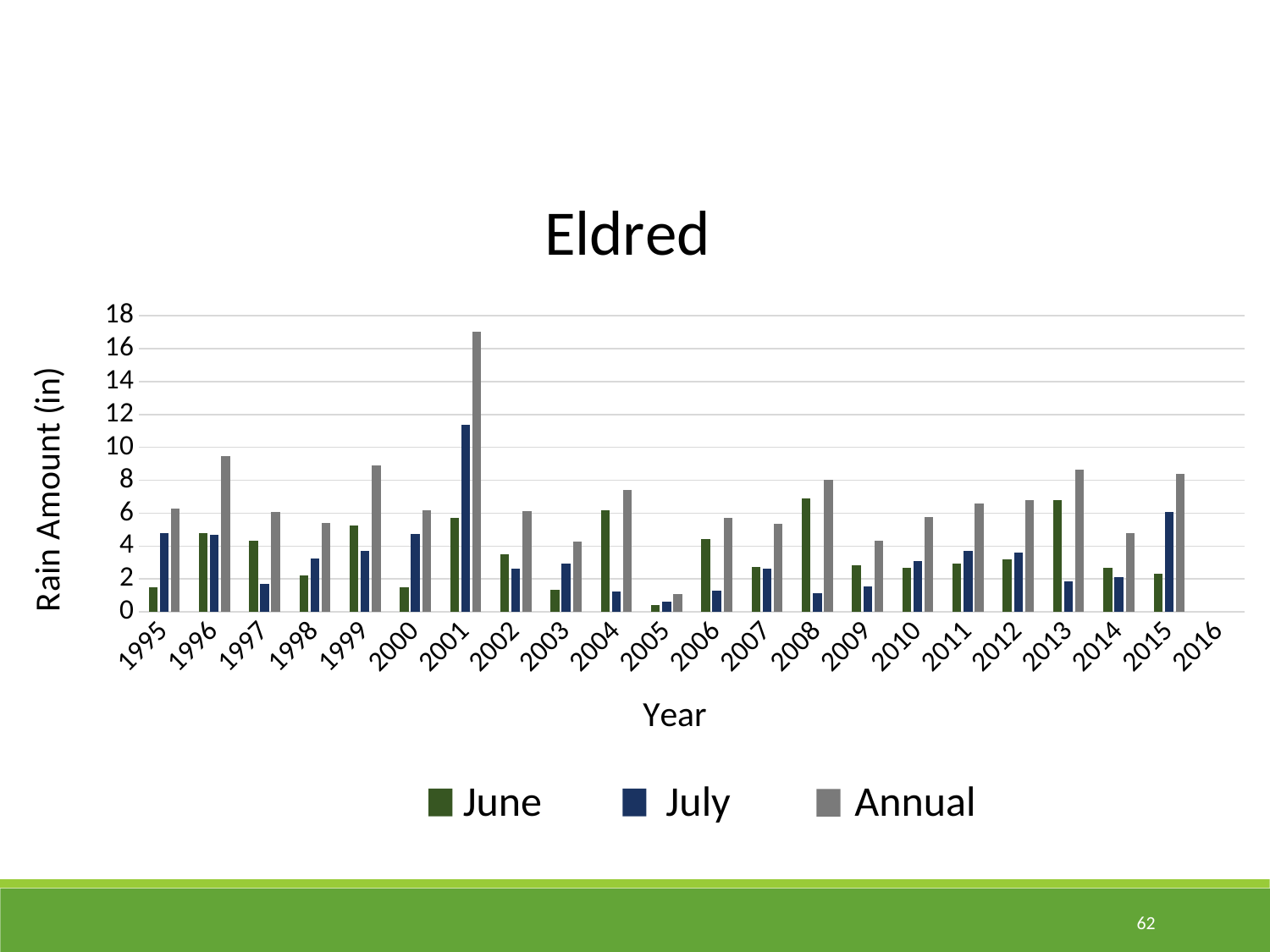
How many series does the legend list? 3 What is the title of the chart? Eldred Is the Annual value for 2001 greater or less than 16? greater In 2004, which is larger, the June value or the July value? June Is the July value for 2001 greater or less than 10? greater In 2015, which is larger, the June value or the July value? July What kind of chart is shown on the slide? bar chart Is the June value for 2005 greater or less than 2? less Which year has the highest July rain amount? 2001 Which year has the highest Annual rain amount? 2001 Which year has the lowest Annual rain amount? 2005 How many years are labelled on the x axis? 22